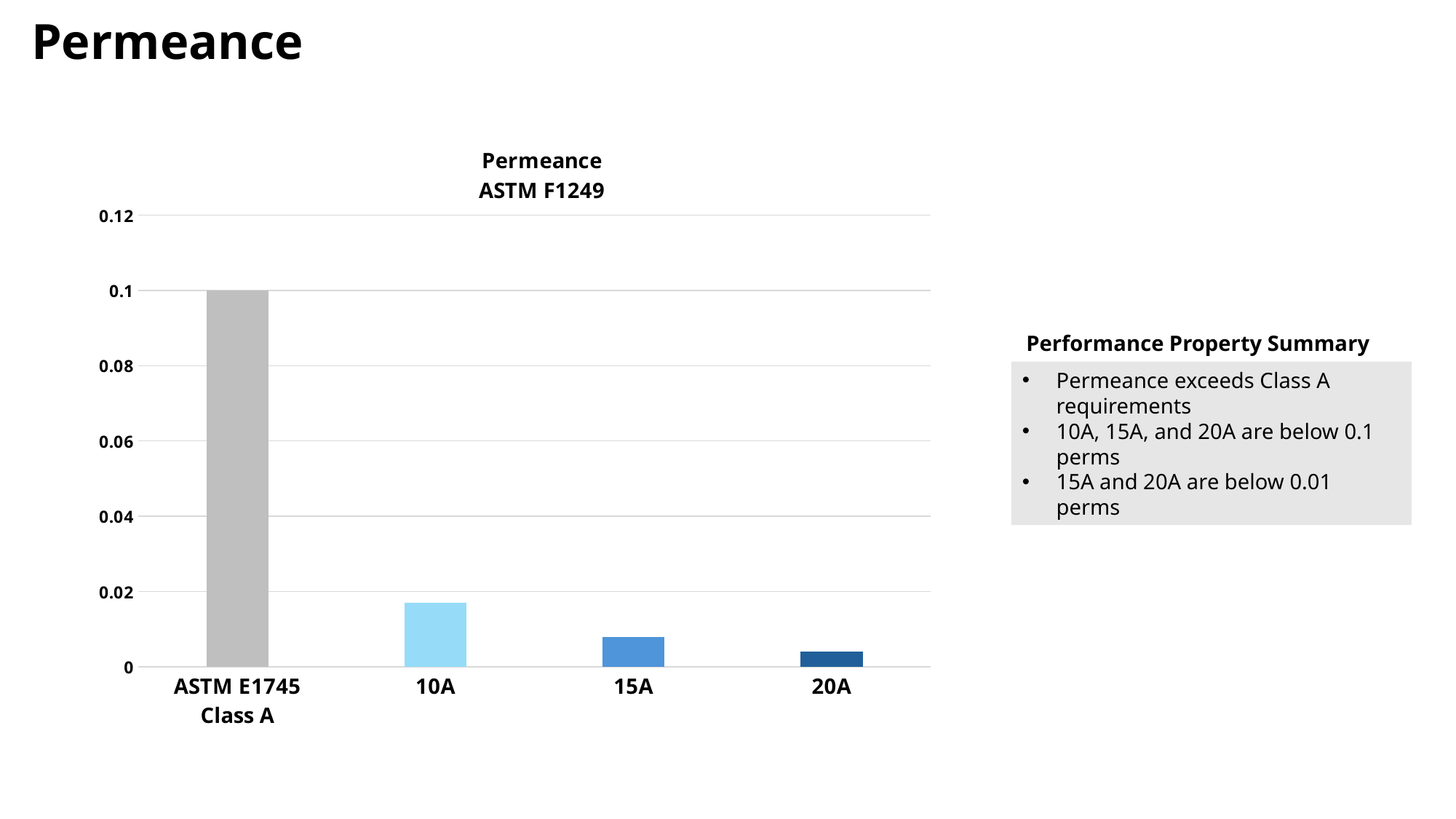
Is the value for ASTM E1745 Class A greater or less than 0.08? greater What colour is the bar for ASTM E1745 Class A? grey Is the value for 10A greater or less than 0.02? less Is the value for 15A greater or less than 0.02? less Which category has the lowest value? 20A What is the title of the chart? Permeance ASTM F1249 Which is larger, the value for 10A or the value for 15A? 10A What kind of chart is shown on the slide? bar chart How many categories are plotted on the x axis of the chart? 4 Which category has the highest value? ASTM E1745 Class A Do the values rise or fall moving from left to right along the x axis? fall What is the value for ASTM E1745 Class A? 0.1